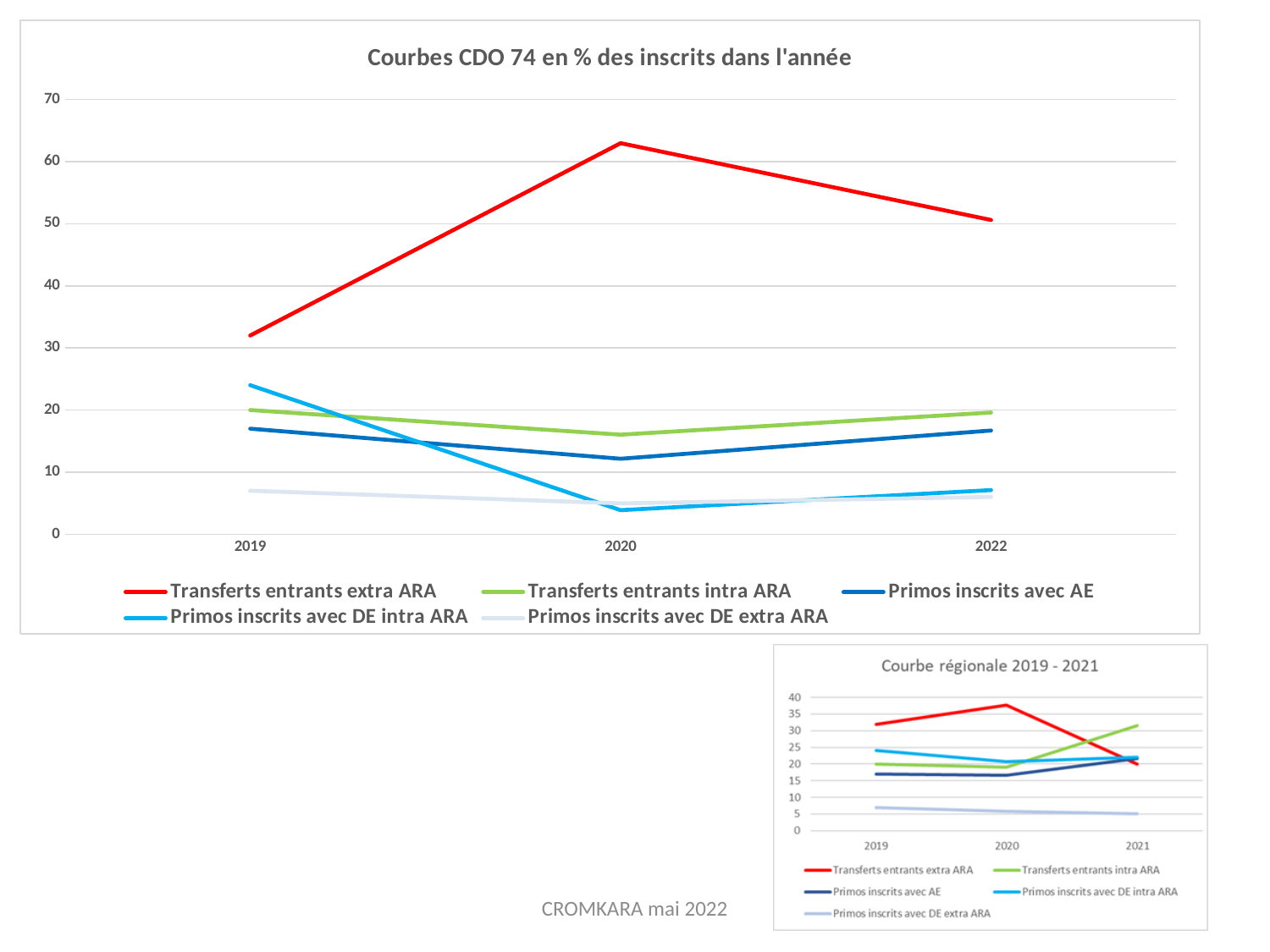
In the 'Courbes CDO 74 en % des inscrits dans l'année' chart, is the value for Transferts entrants extra ARA in 2020 greater or less than 60? greater In the 'Courbe régionale 2019 - 2021' chart, which series has the lowest value in 2019? Primos inscrits avec DE extra ARA In the 'Courbes CDO 74 en % des inscrits dans l'année' chart, does the Transferts entrants extra ARA line rise or fall from 2020 to 2022? fall What kind of chart is the 'Courbes CDO 74 en % des inscrits dans l'année' chart? line chart In the 'Courbes CDO 74 en % des inscrits dans l'année' chart, which is higher in 2019: Primos inscrits avec DE intra ARA or Transferts entrants intra ARA? Primos inscrits avec DE intra ARA In the 'Courbe régionale 2019 - 2021' chart, which series has the highest value in 2021? Transferts entrants intra ARA How many series does the legend of the 'Courbes CDO 74 en % des inscrits dans l'année' chart list? 5 In the 'Courbe régionale 2019 - 2021' chart, does the Transferts entrants extra ARA line rise or fall from 2020 to 2021? fall In the 'Courbes CDO 74 en % des inscrits dans l'année' chart, is the value for Transferts entrants extra ARA in 2019 greater or less than 40? less In the 'Courbes CDO 74 en % des inscrits dans l'année' chart, which series has the highest value in 2020? Transferts entrants extra ARA How many years are shown on the x axis of the 'Courbes CDO 74 en % des inscrits dans l'année' chart? 3 In the 'Courbes CDO 74 en % des inscrits dans l'année' chart, what colour is the Transferts entrants extra ARA line? red